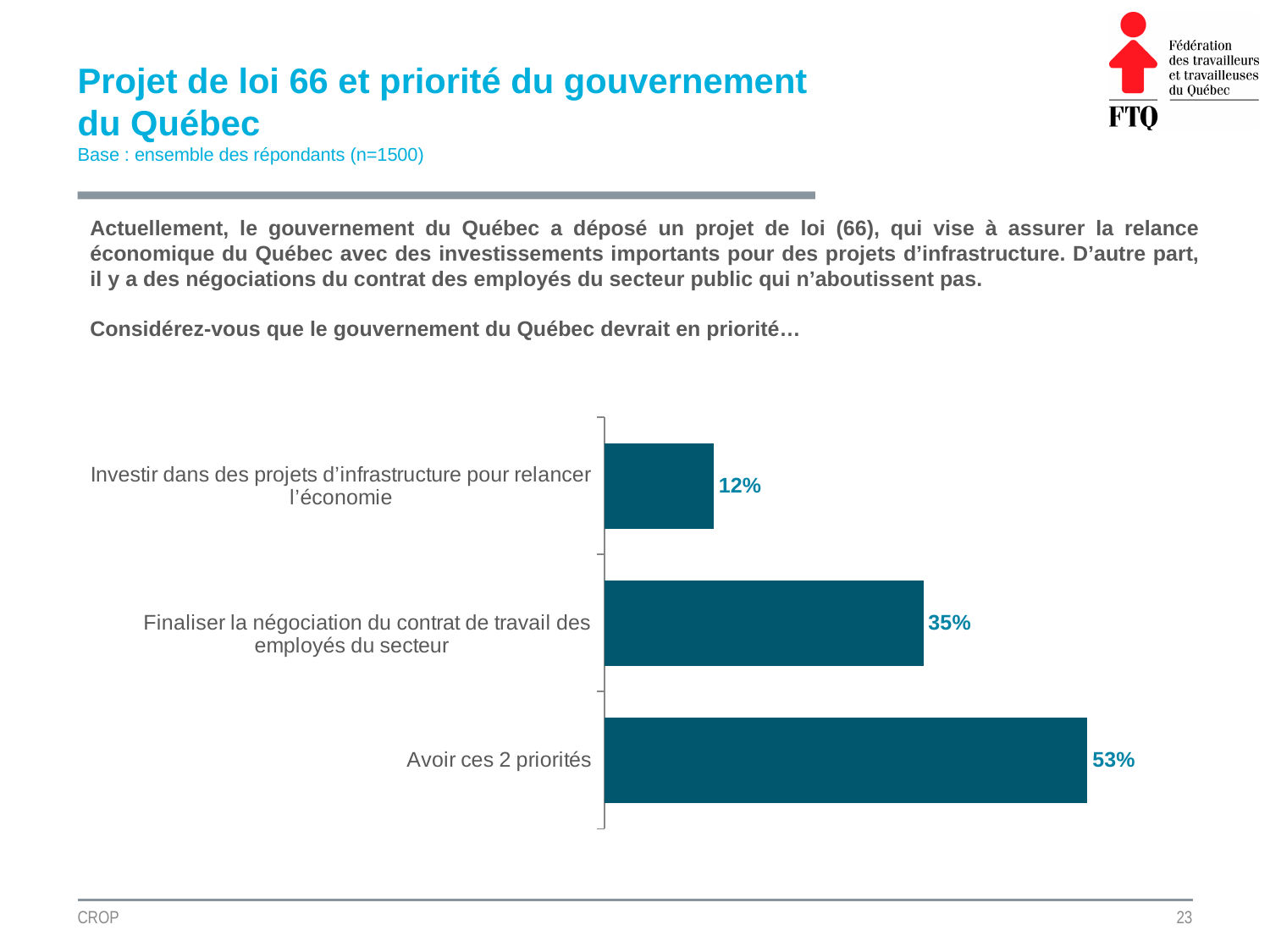
What is the value for "Finaliser la négociation du contrat de travail des employés du secteur"? 35% What colour are the bars in the chart? Dark teal How many categories are shown in the chart? 3 What is the difference between the value for "Finaliser la négociation du contrat de travail des employés du secteur" and the value for "Investir dans des projets d'infrastructure pour relancer l'économie"? 23% What is the sample size (n) stated in the base line under the slide title? 1500 What is the value for "Investir dans des projets d'infrastructure pour relancer l'économie"? 12% What percentage of respondents chose "Avoir ces 2 priorités"? 53% Which is larger: the value for "Finaliser la négociation du contrat de travail des employés du secteur" or the value for "Investir dans des projets d'infrastructure pour relancer l'économie"? Finaliser la négociation du contrat de travail des employés du secteur What is the difference between the value for "Avoir ces 2 priorités" and the value for "Finaliser la négociation du contrat de travail des employés du secteur"? 18% Which category has the highest value? Avoir ces 2 priorités Which category has the lowest value? Investir dans des projets d'infrastructure pour relancer l'économie What kind of chart is shown on the slide? Bar chart